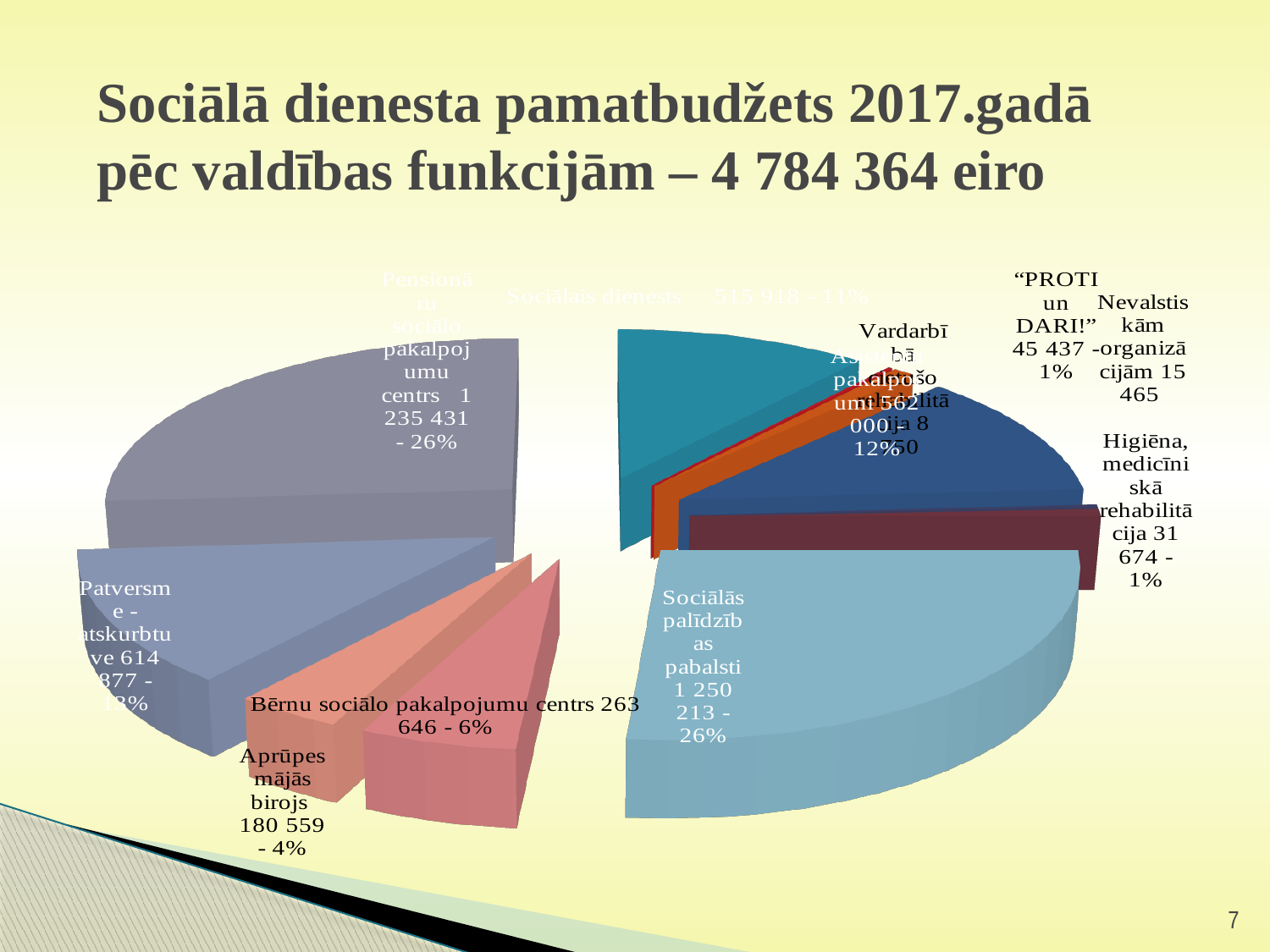
What share of the pie does Bērnu sociālo pakalpojumu centrs represent? 6% What is the value shown for Pensionāru sociālo pakalpojumu centrs? 1 235 431 What share of the pie does Aprūpes mājās birojs represent? 4% Which category has the smallest value in the pie chart? Vardarbībā cietušo rehabilitācija What is the difference between the values for Bērnu sociālo pakalpojumu centrs and Aprūpes mājās birojs? 83 087 What is the value shown for Higiēna, medicīniskā rehabilitācija? 31 674 What kind of chart is shown on the slide? pie chart What total budget amount is stated in the slide title? 4 784 364 eiro Which is larger: Sociālās palīdzības pabalsti or Pensionāru sociālo pakalpojumu centrs? Sociālās palīdzības pabalsti What is the value shown for Aprūpes mājās birojs? 180 559 What is the value shown for Bērnu sociālo pakalpojumu centrs? 263 646 What is the difference between the values for Sociālās palīdzības pabalsti and Pensionāru sociālo pakalpojumu centrs? 14 782